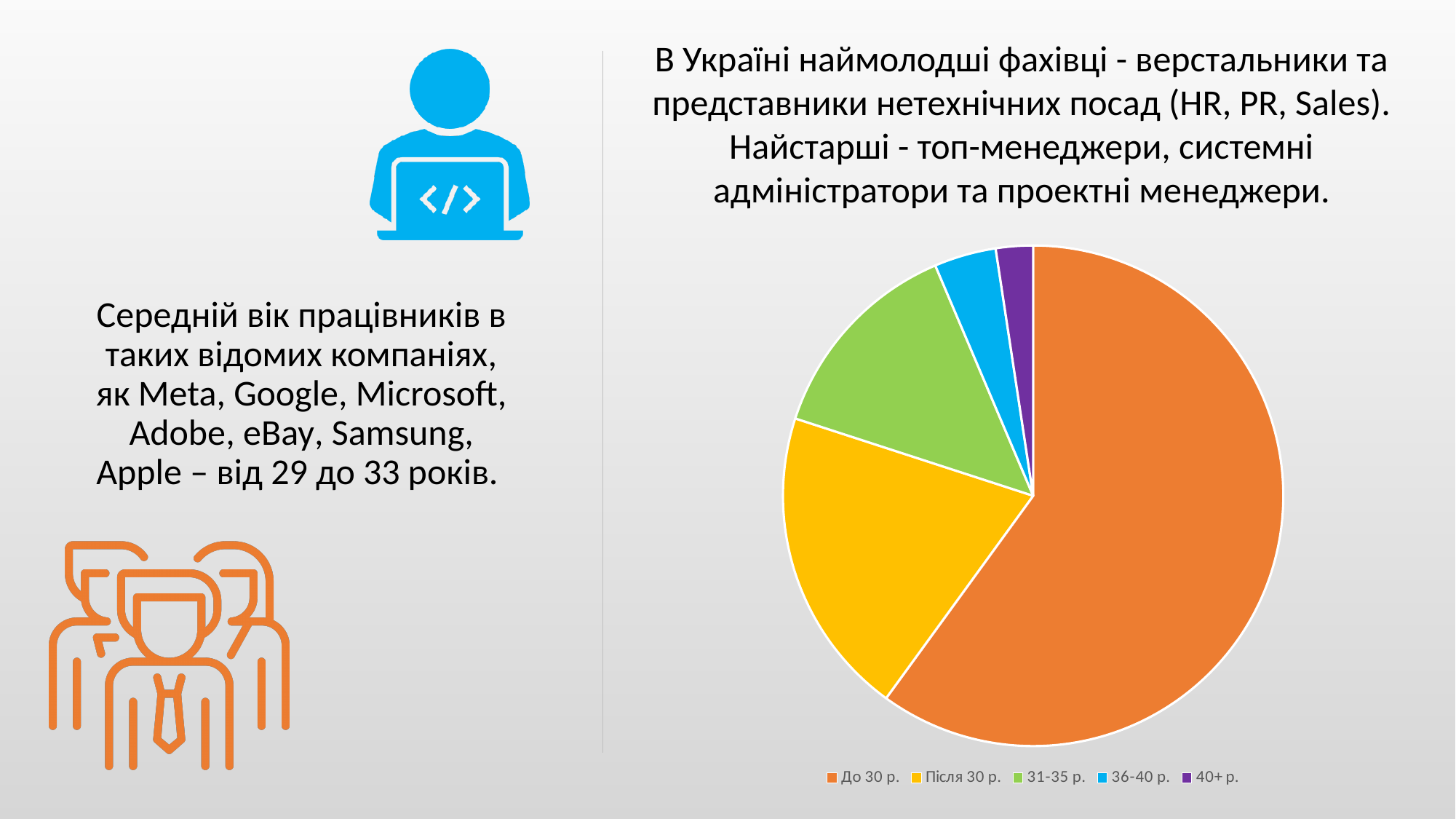
Does the slice for До 30 р. take up more or less than half of the pie? more What colour is the slice for 31-35 р. in the pie chart? green Which category has the largest slice of the pie chart? До 30 р. Which category is shown in purple in the pie chart? 40+ р. Which slice is larger: 36-40 р. or 40+ р.? 36-40 р. Which slice is larger: 31-35 р. or 36-40 р.? 31-35 р. Which slice is larger: Після 30 р. or 31-35 р.? Після 30 р. What kind of chart is shown on the slide? pie chart Which category has the smallest slice of the pie chart? 40+ р. How many slices does the pie chart have? 5